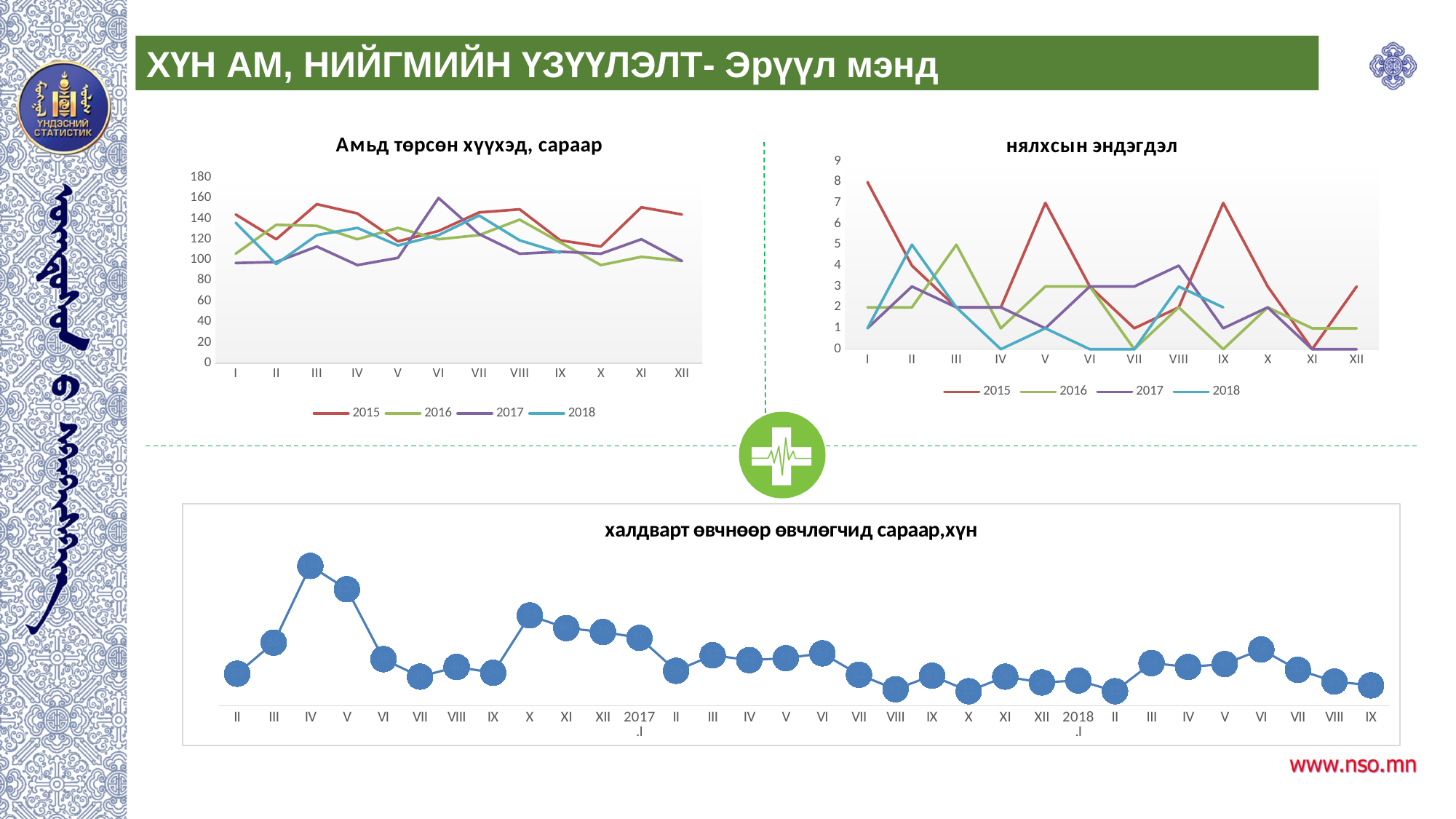
In the 'Амьд төрсөн хүүхэд, сараар' chart, is the 2017 value for month VI greater or less than 140? greater In the 'Амьд төрсөн хүүхэд, сараар' chart, is the 2015 value for month XI greater or less than 140? greater In the 'нялхсын эндэгдэл' chart, what is the 2018 value for month II? 5 In the 'нялхсын эндэгдэл' chart, what is the difference between the 2015 values for month I and month XII? 5 How many data points are plotted in the 'халдварт өвчнөөр өвчлөгчид сараар,хүн' chart? 32 How many months are shown on the x axis of the 'Амьд төрсөн хүүхэд, сараар' chart? 12 In the 'нялхсын эндэгдэл' chart, which month has the highest 2015 value? I In the 'халдварт өвчнөөр өвчлөгчид сараар,хүн' chart, which month has the highest value? IV (the first IV, before 2017.I) In the 'нялхсын эндэгдэл' chart, what is the 2015 value for month I? 8 In the 'нялхсын эндэгдэл' chart, which is larger: the 2016 value for month III or the 2017 value for month III? 2016 How many series does the legend of the 'Амьд төрсөн хүүхэд, сараар' chart list? 4 What kind of chart is the 'Амьд төрсөн хүүхэд, сараар' chart? line chart